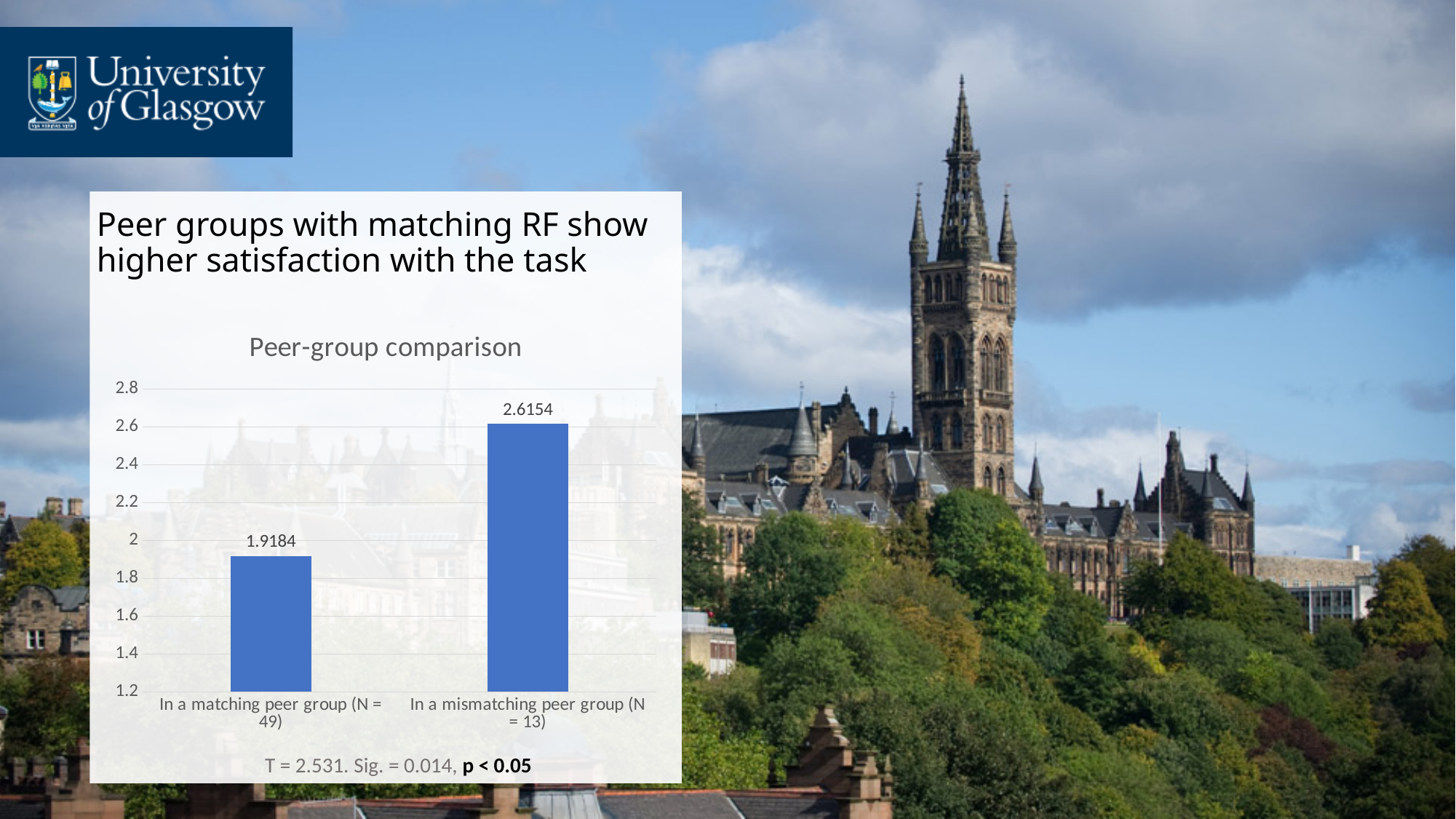
What is the value for 'In a matching peer group (N = 49)'? 1.9184 What is the title of the chart? Peer-group comparison What is the value for 'In a mismatching peer group (N = 13)'? 2.6154 Is the value for 'In a matching peer group (N = 49)' greater or less than 2? less Which category has the highest value? In a mismatching peer group (N = 13) Which category has the lowest value? In a matching peer group (N = 49) How many categories are shown in the chart? 2 What is the lowest value shown on the vertical axis of the chart? 1.2 What kind of chart is shown on the slide? bar chart Which is larger: the value for the matching peer group or the mismatching peer group? In a mismatching peer group (N = 13) What is the difference between the mismatching peer group value and the matching peer group value? 0.697 Is the value for 'In a mismatching peer group (N = 13)' greater or less than 2.4? greater